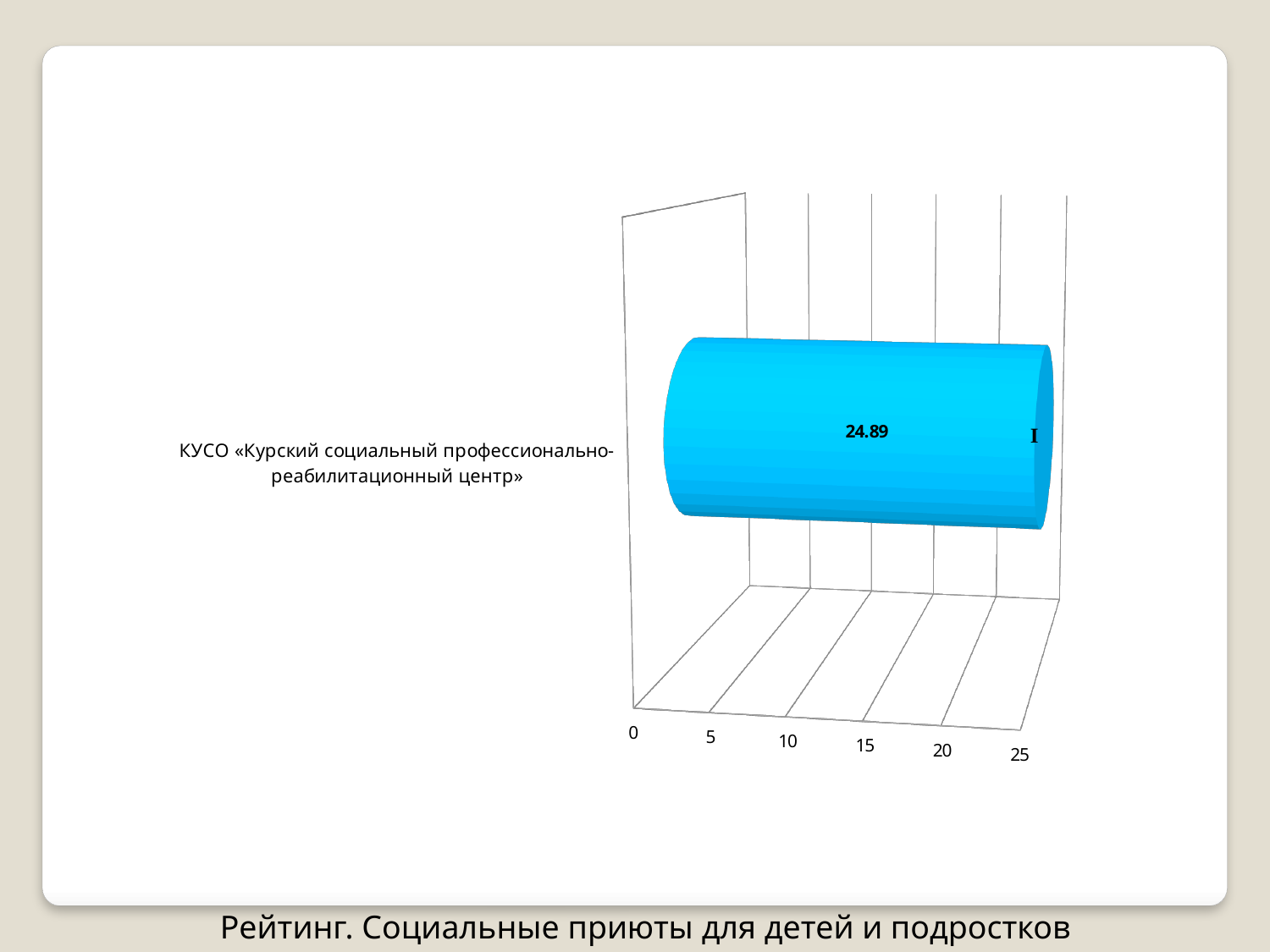
What value is shown for КУСО «Курский социальный профессионально-реабилитационный центр»? 24.89 What rank label is printed at the end of the bar? I What kind of chart is shown on the slide? Bar chart What is the title text shown at the bottom of the slide? Рейтинг. Социальные приюты для детей и подростков What is the maximum value shown on the chart's value axis? 25 How many categories are plotted on the chart? 1 Is the value for КУСО «Курский социальный профессионально-реабилитационный центр» greater or less than 25? less Which category has the highest value on the chart? КУСО «Курский социальный профессионально-реабилитационный центр» Is the value for КУСО «Курский социальный профессионально-реабилитационный центр» greater or less than 20? greater